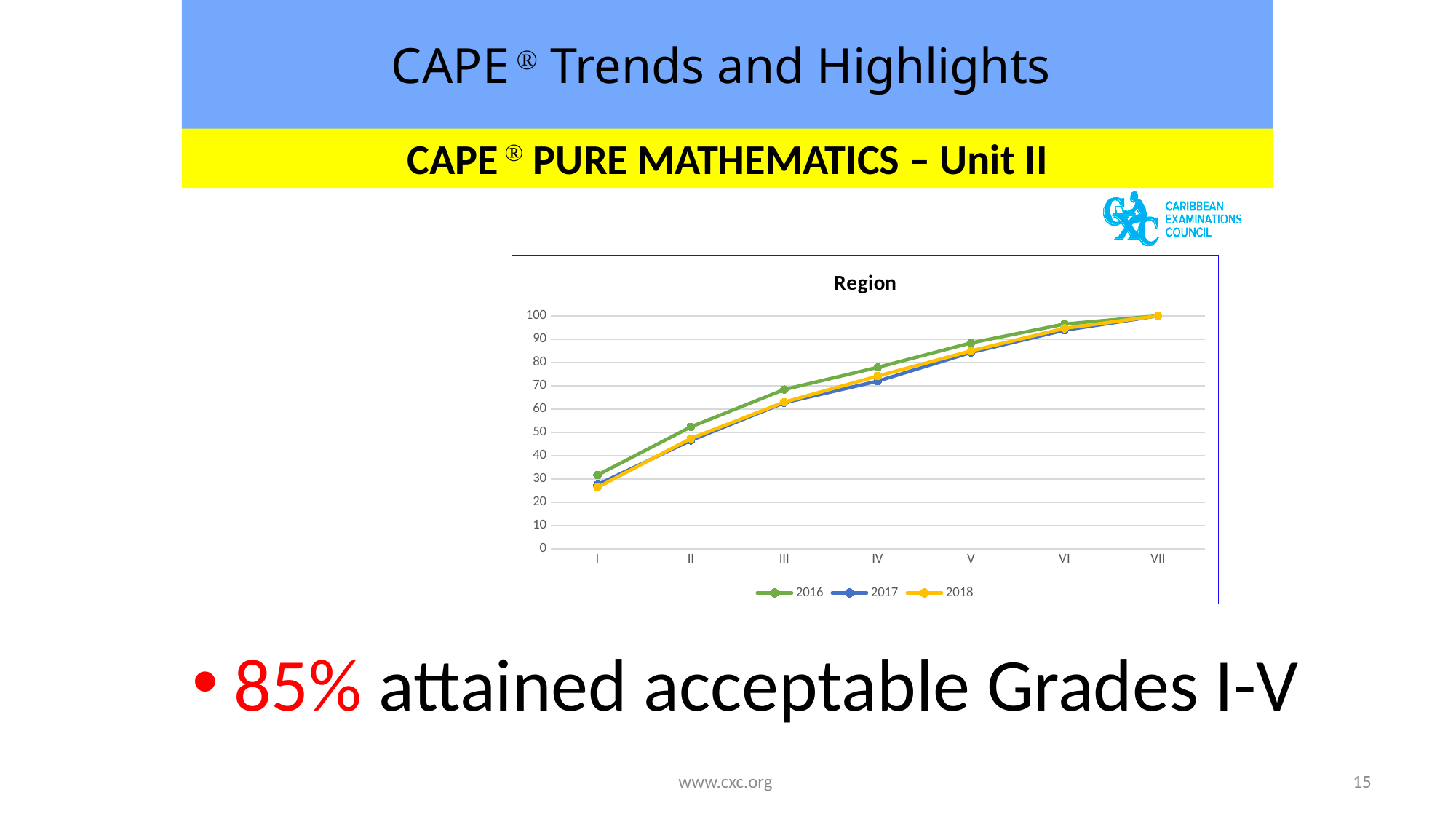
What value do all three series reach at grade VII? 100 At grade III, which is larger: the value for 2016 or the value for 2018? 2016 What is the title of the chart? Region Is the value for 2018 at grade II greater or less than 50? less How many grade categories are shown along the x axis of the chart? 7 Is the value for 2016 at grade V greater or less than 80? greater How many series does the legend of the chart list? 3 Which series has the highest value at grade I? 2016 What kind of chart is shown on the slide? line chart Do the values for the 2016 series rise or fall from grade I to grade VII? rise Is the value for 2016 at grade I greater or less than 40? less Which years are listed in the chart's legend? 2016, 2017, 2018